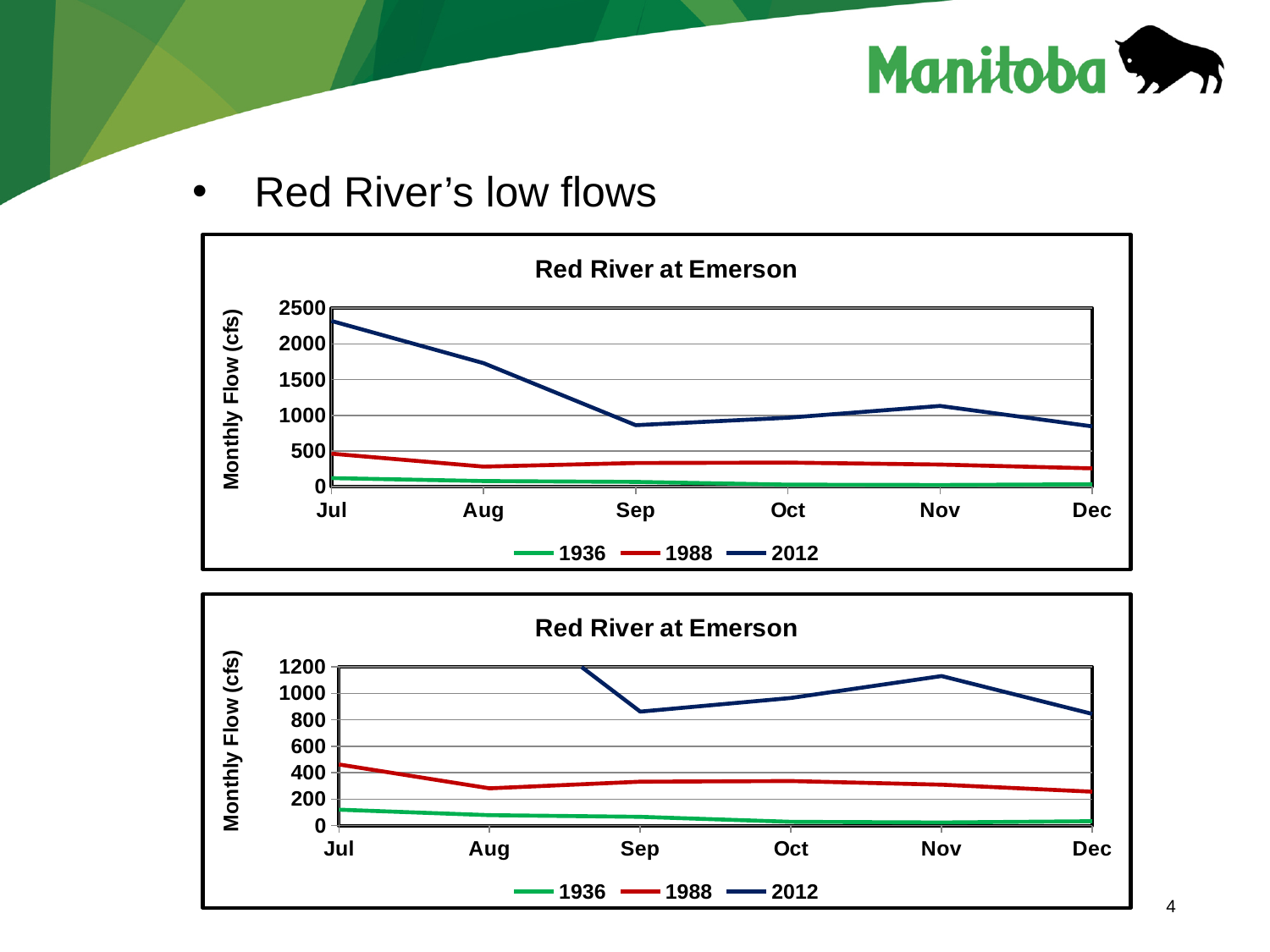
In the bottom chart, is the 1988 value for Aug greater or less than 400? less What kind of chart is the top chart on the slide? line chart How many series does the legend of the top chart list? 3 What is the y-axis label of the top chart? Monthly Flow (cfs) How many months are shown on the x axis of the bottom chart? 6 In the bottom chart, which series has the lowest values across all months? 1936 In the bottom chart, which is larger for 2012: the value for Nov or the value for Oct? Nov In the bottom chart, is the 1988 value for Jul greater or less than 400? greater In the top chart, does the 2012 line rise or fall from Jul to Sep? fall In the top chart, is the 2012 value for Jul greater or less than 2000? greater In the top chart, which month has the highest 2012 value? Jul